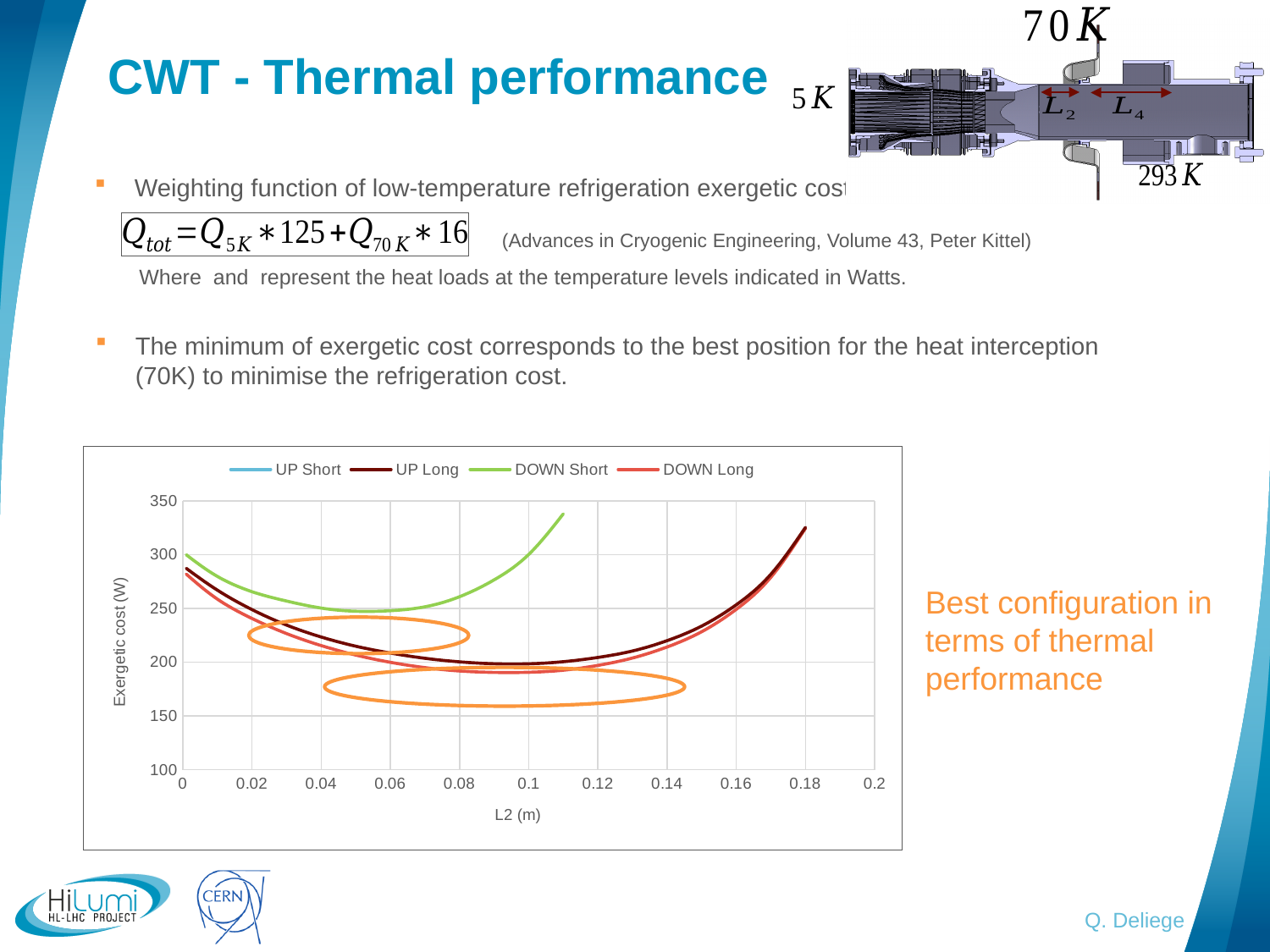
What kind of chart is shown on the slide? line chart Is the value of the UP Long series at L2 = 0.18 greater or less than 300? greater Is the value of the DOWN Short series at L2 = 0 greater or less than 250? greater Is the lowest point of the DOWN Long curve greater or less than 250? less What is the label of the x axis of the chart? L2 (m) Does the DOWN Short curve rise or fall as L2 increases from 0.06 to 0.11? rise Does the UP Long curve rise or fall as L2 increases from 0 to 0.08? fall How many series does the chart legend list? 4 What is the label of the y axis of the chart? Exergetic cost (W) At L2 = 0.1, which series has the larger exergetic cost, DOWN Short or UP Long? DOWN Short